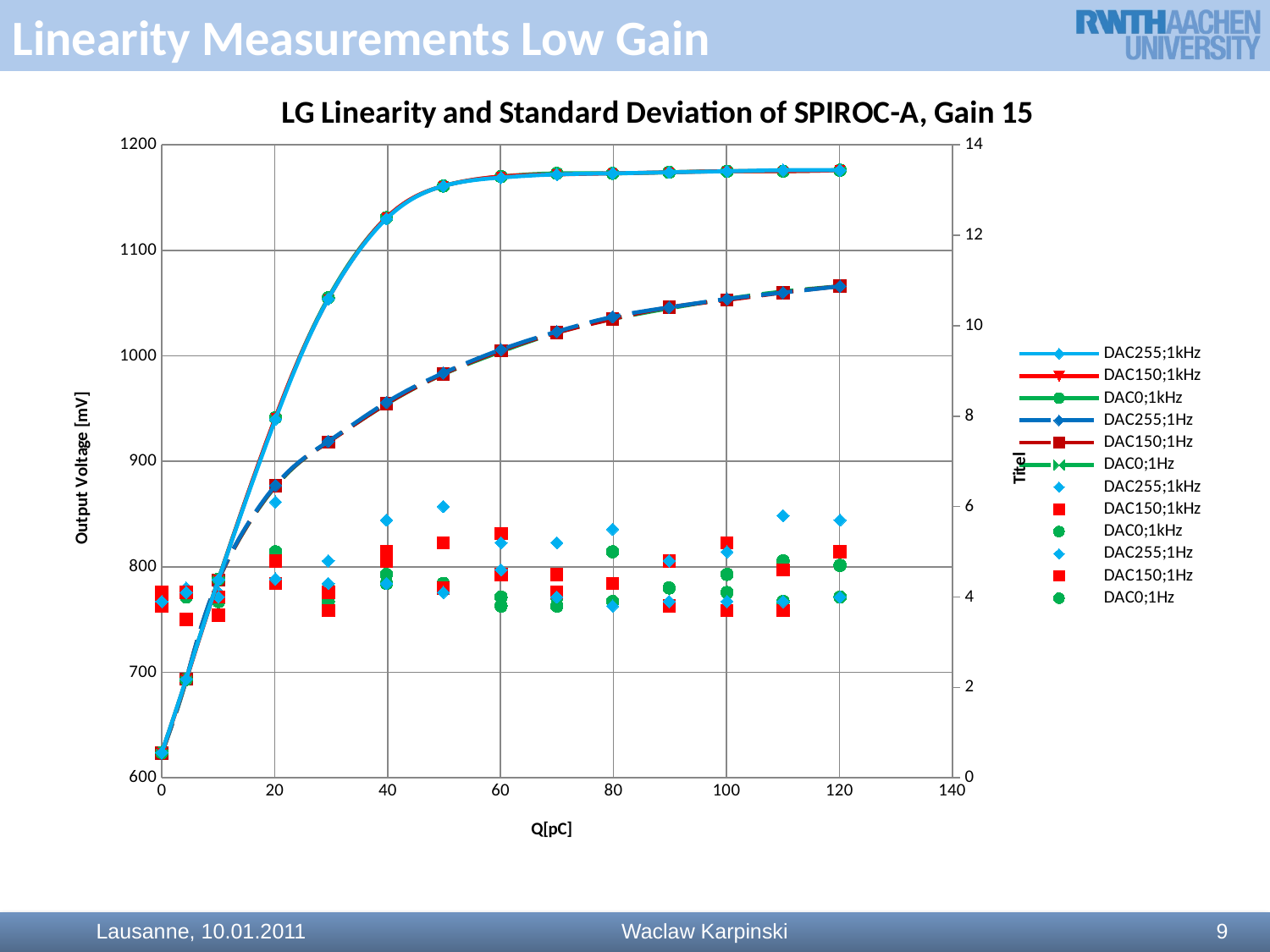
What is the label of the x axis? Q[pC] Is the value of the DAC255;1kHz line at Q = 120 greater or less than 1100? greater What is the title of the chart? LG Linearity and Standard Deviation of SPIROC-A, Gain 15 Is the value of the DAC150;1kHz line at Q = 20 greater or less than 900? greater What is the maximum value shown on the right-hand secondary axis? 14 How many series does the chart's legend list? 12 At Q = 120, which is larger: the DAC255;1kHz line or the DAC255;1Hz line? DAC255;1kHz Is the value of the dashed DAC255;1Hz line at Q = 120 greater or less than 1100? less Do the DAC255;1kHz line values rise or fall as Q increases from 0 to 120? rise